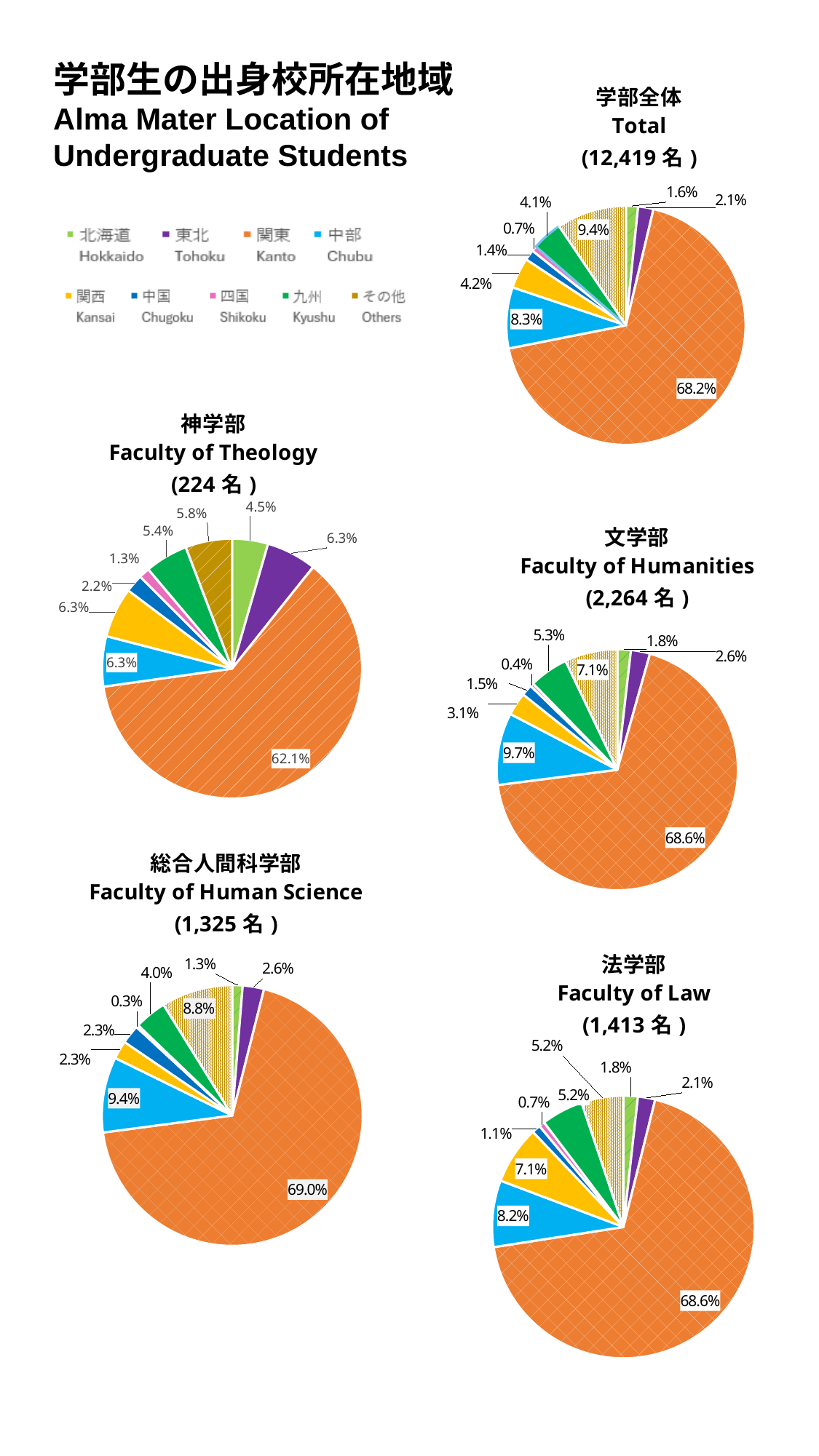
In the Faculty of Theology pie chart, what percentage is shown for Kanto? 62.1% In the Faculty of Humanities pie chart, which region has the smallest share? Shikoku In the Faculty of Law pie chart, what percentage is shown for Kansai? 7.1% In the Faculty of Human Science pie chart, which is larger, the Chubu share or the Kyushu share? Chubu In the Faculty of Human Science pie chart, what percentage is shown for Others? 8.8% In the Faculty of Humanities pie chart, what percentage is shown for Chubu? 9.7% In the Total pie chart, what percentage is shown for Chubu? 8.3% In the Total (学部全体) pie chart, what share of undergraduate students come from Kanto? 68.2% In the Total pie chart, what is the difference between the Chubu share and the Kansai share? 4.1% In the Faculty of Law pie chart, which region has the largest share? Kanto How many regions does the legend list? 9 What kind of chart is used for the Faculty of Theology data? Pie chart